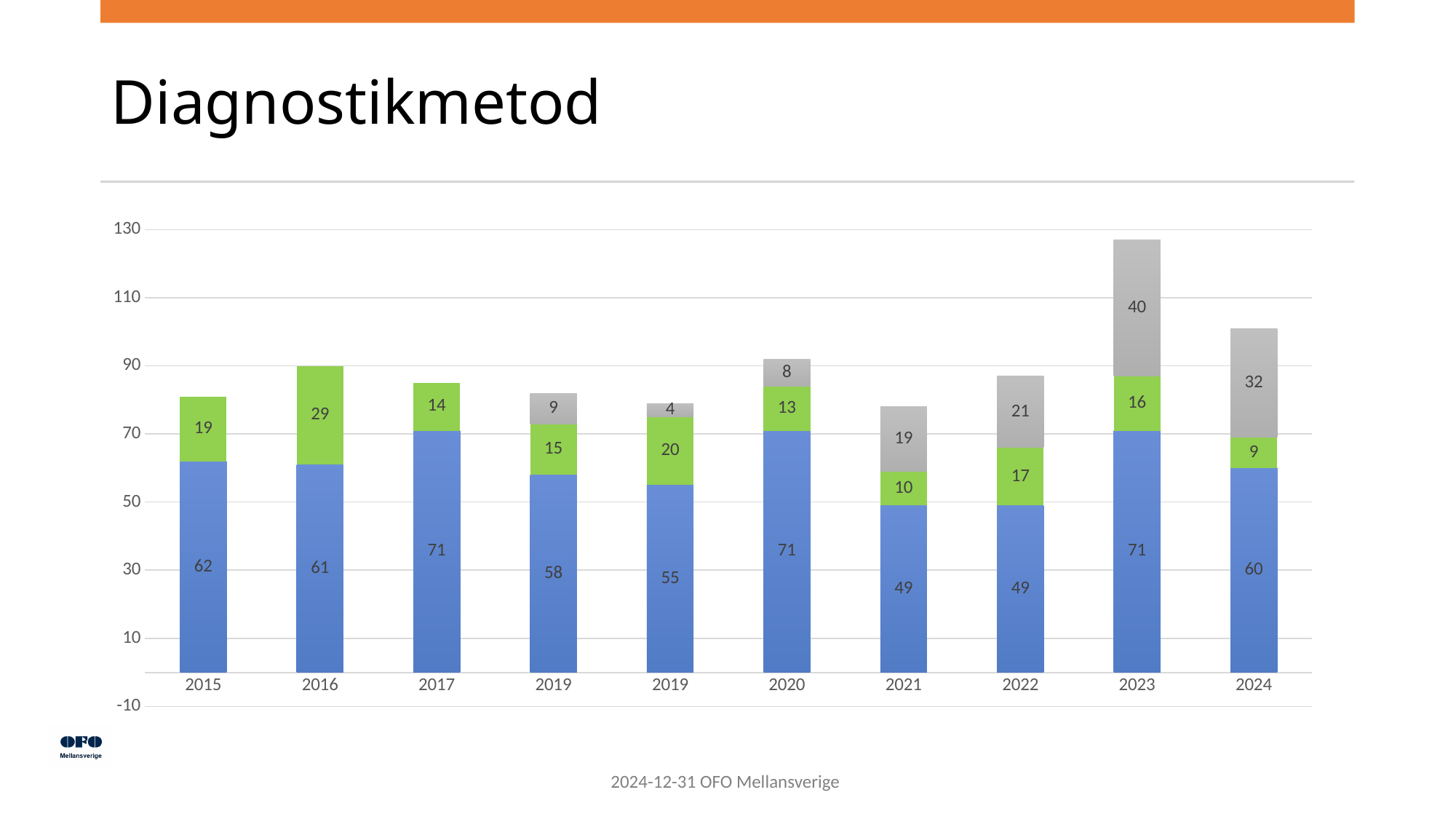
Is the total height of the bar for 2021 greater or less than 90? less What is the total of the stacked bar for 2023? 127 What is the value of the blue segment for 2015? 62 What kind of chart is shown on the slide? Stacked bar chart How many bars are plotted in the chart? 10 Which year has the tallest bar overall? 2023 What is the title of the chart on the slide? Diagnostikmetod Which year has the largest grey segment? 2023 Which year has the smallest green segment? 2024 What is the difference between the grey segment for 2023 and the grey segment for 2024? 8 What is the value of the grey segment for 2023? 40 What is the value of the green segment for 2016? 29